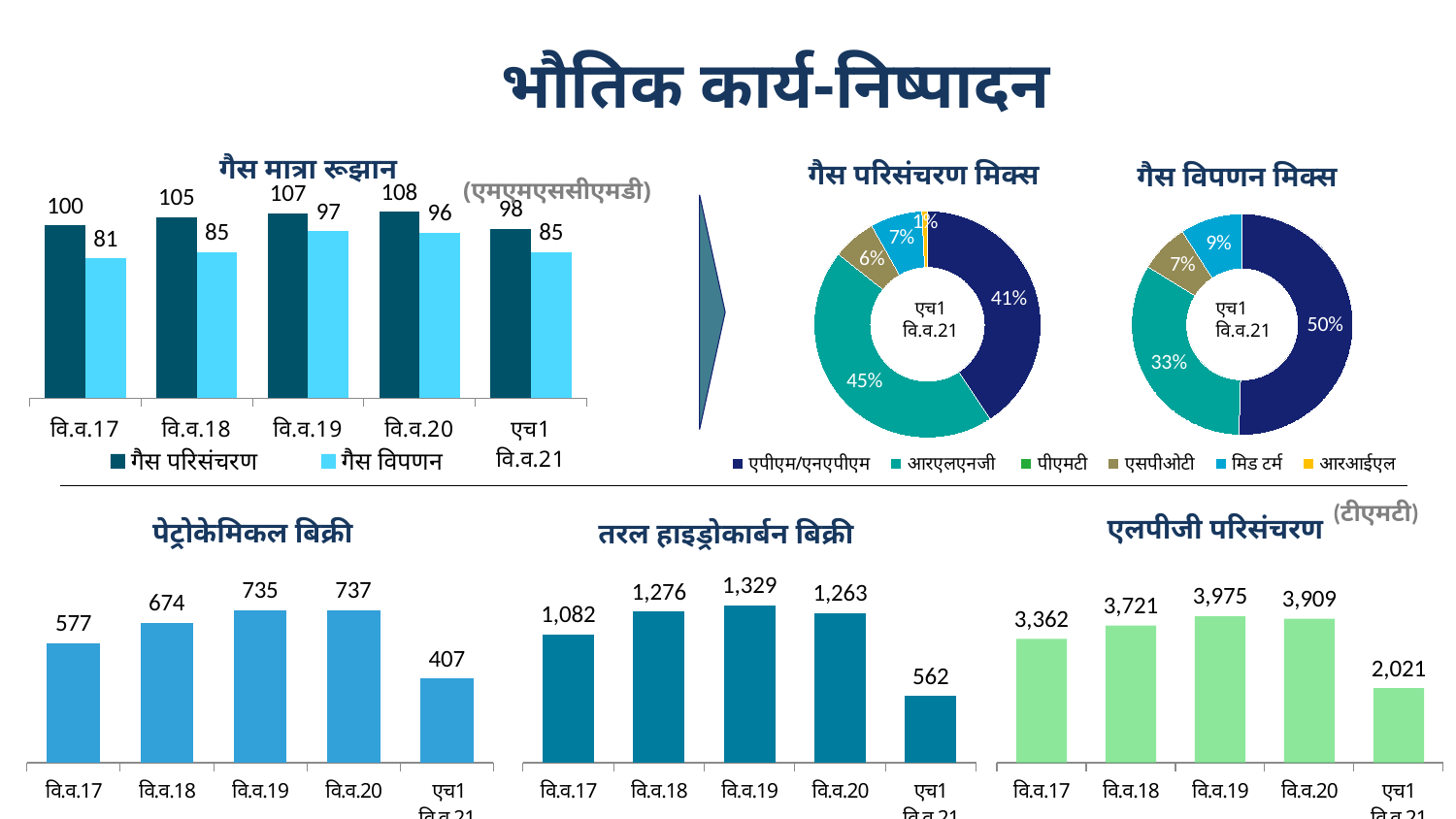
In the 'पेट्रोकेमिकल बिक्री' chart, what is the value for एच1 वि.व.21? 407 In the 'गैस परिसंचरण मिक्स' donut chart, what share does आरएलएनजी have? 45% In the 'एलपीजी परिसंचरण' chart, which period has the lowest value? एच1 वि.व.21 How many series does the legend of the 'गैस मात्रा रूझान' chart list? 2 In the 'गैस मात्रा रूझान' chart, what is the difference between गैस परिसंचरण and गैस विपणन for वि.व.17? 19 In the 'तरल हाइड्रोकार्बन बिक्री' chart, what is the difference between वि.व.19 and वि.व.18? 53 How many entries does the legend of the 'गैस परिसंचरण मिक्स' chart list? 6 In the 'गैस मात्रा रूझान' chart, what is the value of गैस परिसंचरण for वि.व.20? 108 What type of chart is the 'एलपीजी परिसंचरण' chart? Bar chart In the 'पेट्रोकेमिकल बिक्री' chart, which period has the highest value? वि.व.20 In the 'गैस विपणन मिक्स' donut chart, what share does the largest slice (एपीएम/एनएपीएम) have? 50% In the 'गैस मात्रा रूझान' chart, what is the value of गैस विपणन for वि.व.19? 97